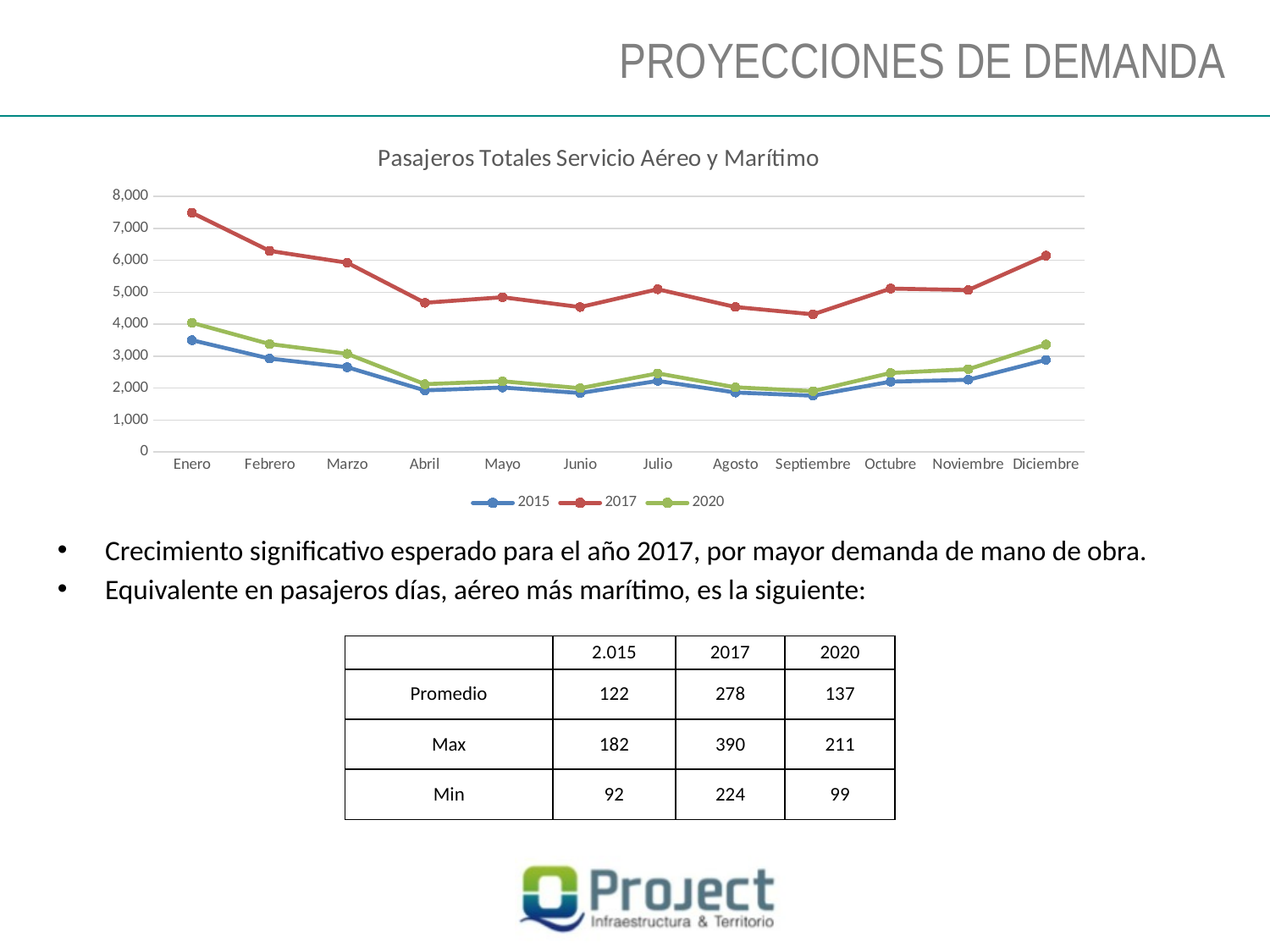
In which month does the 2017 series reach its lowest value? Septiembre What kind of chart is shown on the slide? line chart Does the 2017 series rise or fall from Enero to Abril? fall How many months are plotted along the x axis of the chart? 12 Is the value for 2020 in Diciembre greater or less than 3,000? greater Which series has the larger value in Julio, 2017 or 2015? 2017 In which month does the 2015 series reach its highest value? Enero Is the value for 2017 in Enero greater or less than 7,000? greater How many series does the chart legend list? 3 In which month does the 2017 series reach its highest value? Enero Is the value for 2015 in Enero greater or less than 4,000? less What is the title of the chart? Pasajeros Totales Servicio Aéreo y Marítimo